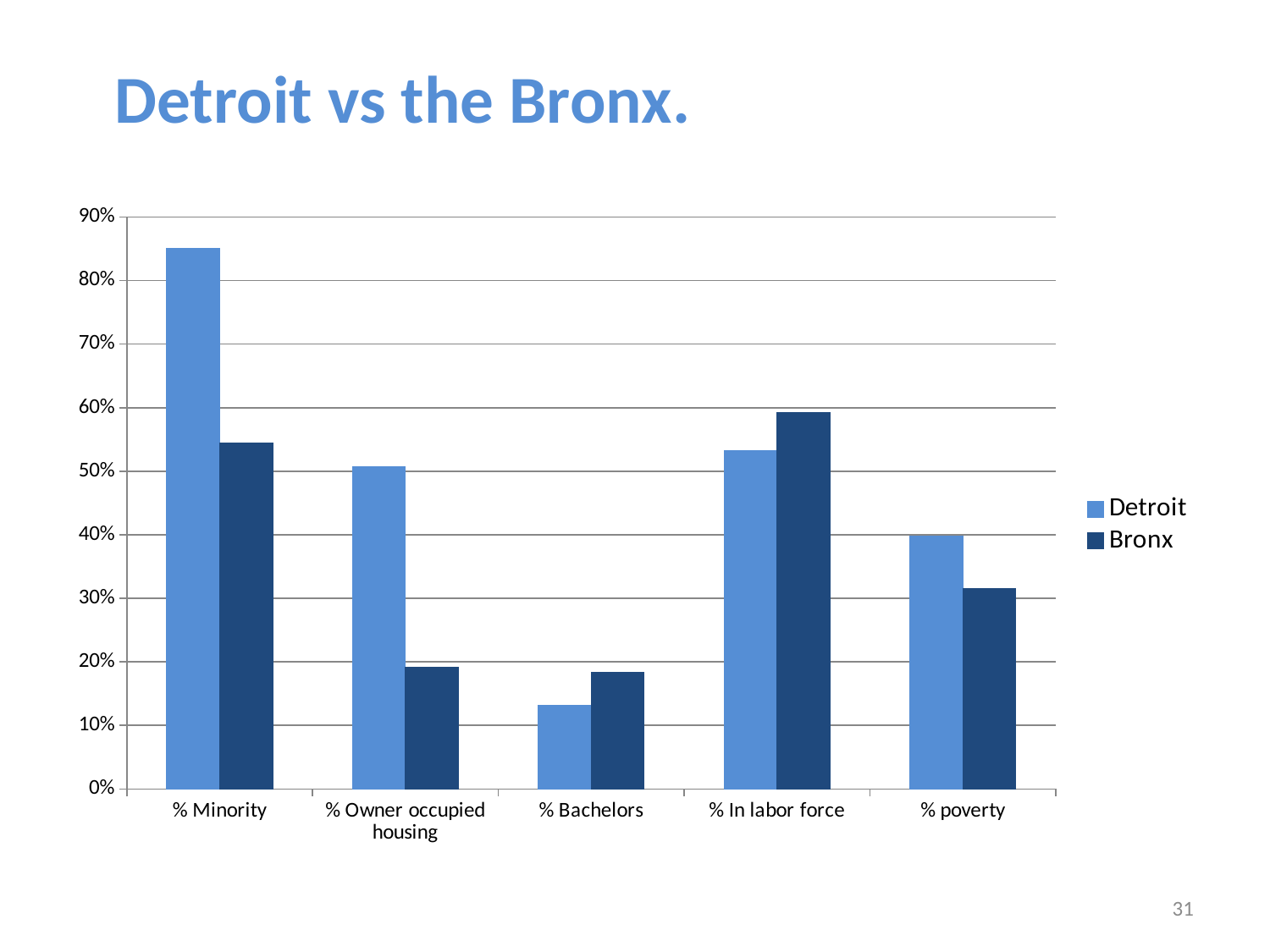
For % poverty, which is larger, Detroit or Bronx? Detroit Which category has the lowest Detroit bar? % Bachelors Is the Bronx value for % Owner occupied housing greater or less than 20%? less What kind of chart is shown on the slide? bar chart Which series is shown in the darker blue colour? Bronx How many categories are shown on the x axis? 5 Which category has the lowest Bronx bar? % Bachelors Which category has the highest Detroit bar? % Minority For % Bachelors, which is larger, Detroit or Bronx? Bronx How many series does the legend list? 2 Is the Detroit value for % Minority greater or less than 80%? greater Which category has the highest Bronx bar? % In labor force